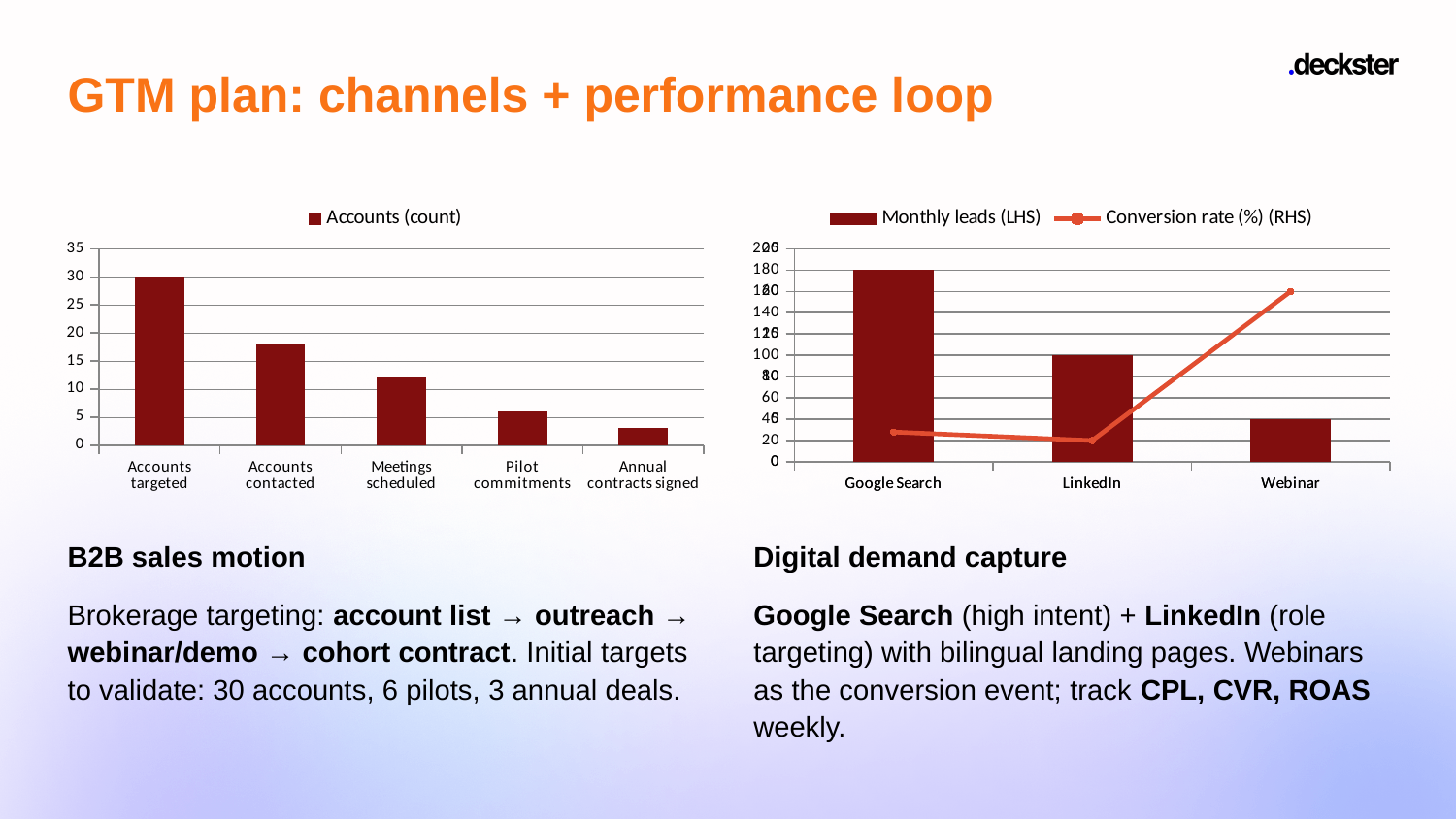
On the right chart, what is the Monthly leads (LHS) value for Google Search? 180 How many series does the legend of the right chart list? 2 On the right chart, which channel has the lowest Monthly leads (LHS)? Webinar On the left chart (Accounts (count)), how many categories are shown on the x axis? 5 On the left chart (Accounts (count)), is the value for Pilot commitments greater or less than 10? less What kind of chart is the left chart (Accounts (count))? bar chart On the left chart (Accounts (count)), which category has the lowest value? Annual contracts signed On the left chart (Accounts (count)), what is the value for Accounts targeted? 30 On the left chart (Accounts (count)), do the values rise or fall from left to right along the x axis? fall On the left chart (Accounts (count)), which category has the highest value? Accounts targeted On the left chart (Accounts (count)), is the value for Accounts contacted greater or less than 15? greater On the right chart, what is the Monthly leads (LHS) value for LinkedIn? 100